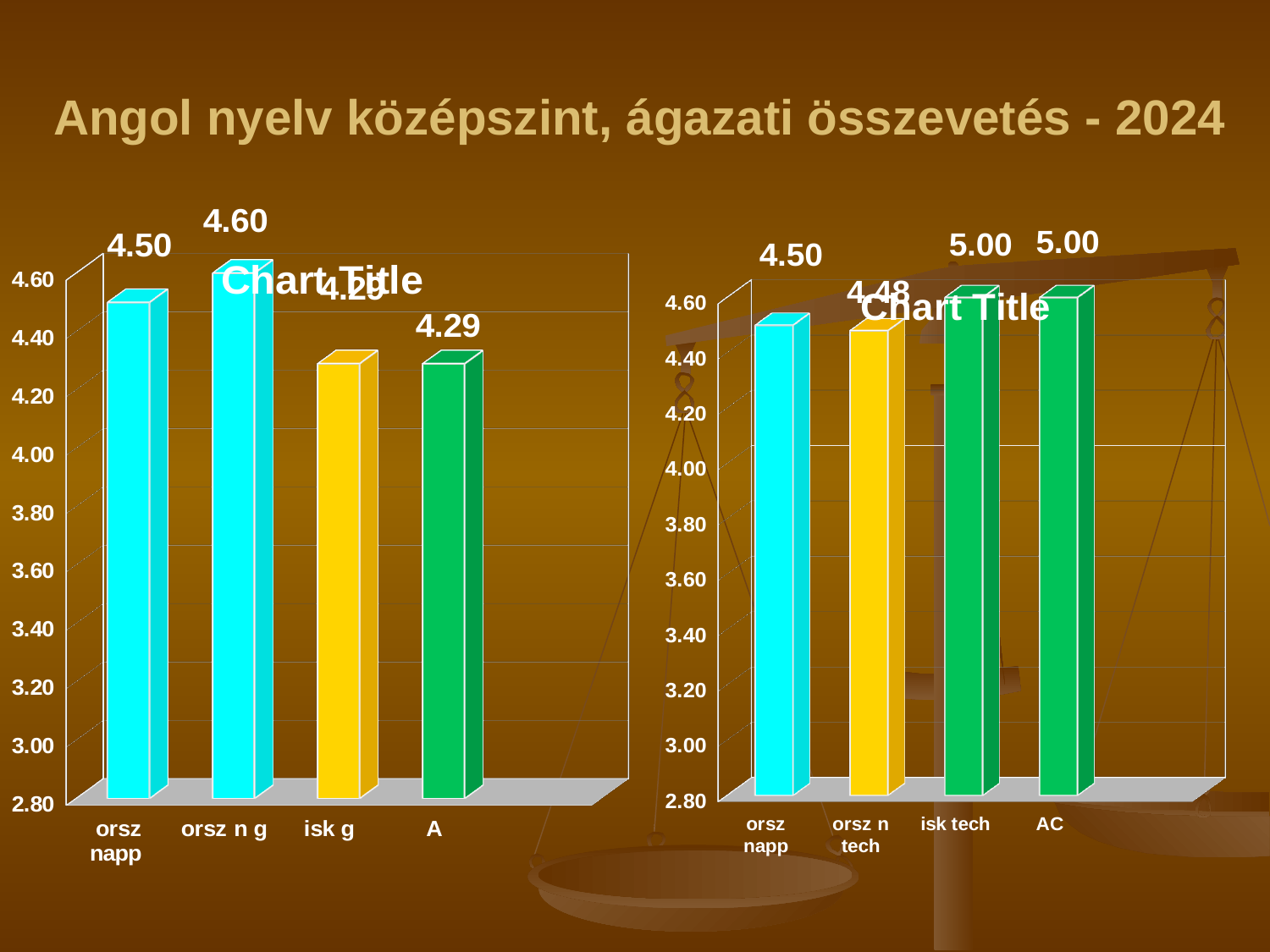
In the right chart, is the value for orsz n tech greater or less than 4.60? less In the left chart, which category has the highest value? orsz n g What kind of chart is the left chart? bar chart In the left chart, what is the value for A? 4.29 How many categories are shown in the right chart? 4 In the right chart, what is the value for AC? 5.00 In the left chart, what is the value for orsz napp? 4.50 In the left chart, which is larger, the value for orsz napp or the value for A? orsz napp In the left chart, what is the value for orsz n g? 4.60 In the right chart, what is the value for isk tech? 5.00 In the left chart, what is the difference between the values for orsz n g and orsz napp? 0.10 In the right chart, what is the difference between the values for AC and orsz napp? 0.50